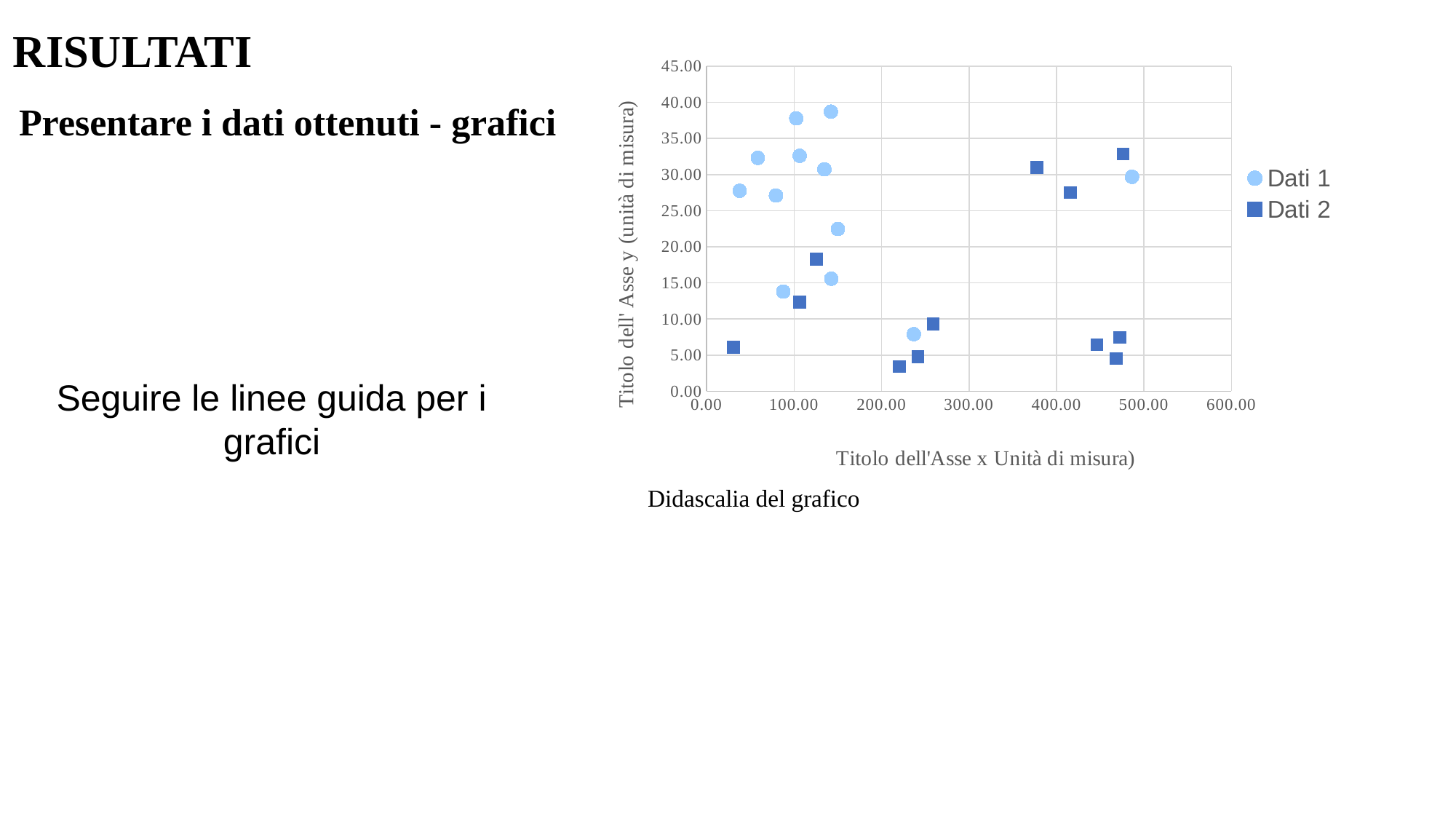
Is the y value of the lowest Dati 2 point greater or less than 5.00? less Is the y value of the highest Dati 1 point greater or less than 35.00? greater What kind of chart is shown on the slide? scatter chart What are the names of the two series in the chart legend? Dati 1 and Dati 2 What is the title of the y axis of the chart? Titolo dell' Asse y (unità di misura) How many series does the chart legend list? 2 Which series is plotted with square markers? Dati 2 Which series reaches the higher maximum y value, Dati 1 or Dati 2? Dati 1 Is the y value of the lowest Dati 1 point greater or less than 10.00? less What is the highest value shown on the y axis of the chart? 45.00 What is the highest value shown on the x axis of the chart? 600.00